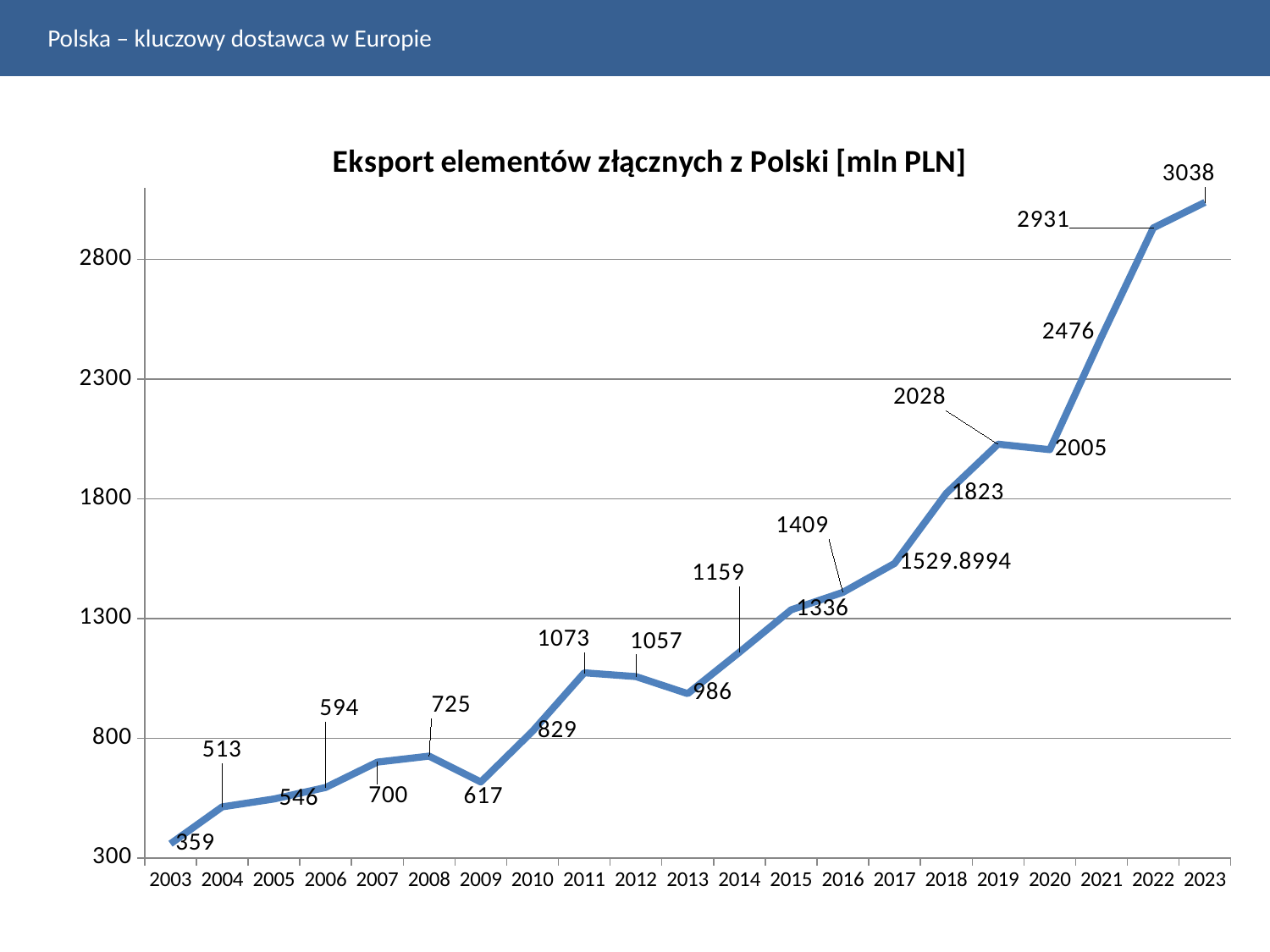
What kind of chart is shown on the slide? line chart What is the value for 2023 in the chart? 3038 What is the value for 2017 in the chart? 1529.8994 What is the difference between the values for 2023 and 2022? 107 What is the value for 2009 in the chart? 617 What is the title of the chart? Eksport elementów złącznych z Polski [mln PLN] How many years are plotted on the x axis? 21 Is the value for 2021 greater or less than 2300? greater Which year has the lowest value in the chart? 2003 What is the difference between the values for 2019 and 2020? 23 Which year has the highest value in the chart? 2023 Which is larger, the value for 2011 or the value for 2012? 2011